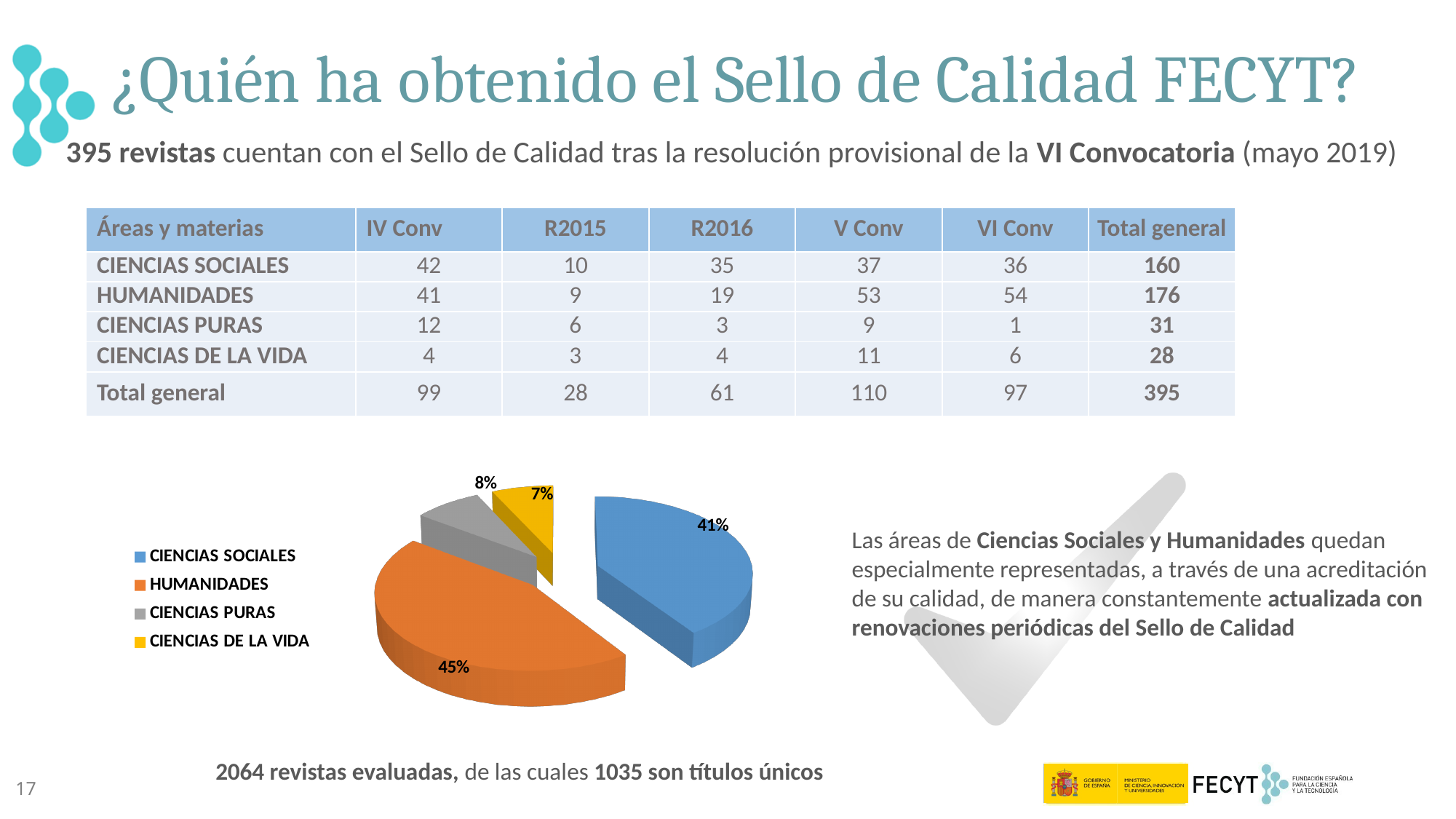
What share of the pie does CIENCIAS PURAS have? 8% Which category has the smallest slice of the pie? CIENCIAS DE LA VIDA Which category has the largest slice of the pie? HUMANIDADES What share of the pie does CIENCIAS SOCIALES have? 41% How many slices does the pie chart have? 4 How many entries does the legend of the pie chart list? 4 What kind of chart is shown on the slide? pie chart Which slice is larger, CIENCIAS PURAS or CIENCIAS DE LA VIDA? CIENCIAS PURAS What share of the pie does HUMANIDADES have? 45% What is the difference in percentage points between the HUMANIDADES slice and the CIENCIAS SOCIALES slice? 4 What colour is the HUMANIDADES slice in the pie chart? orange